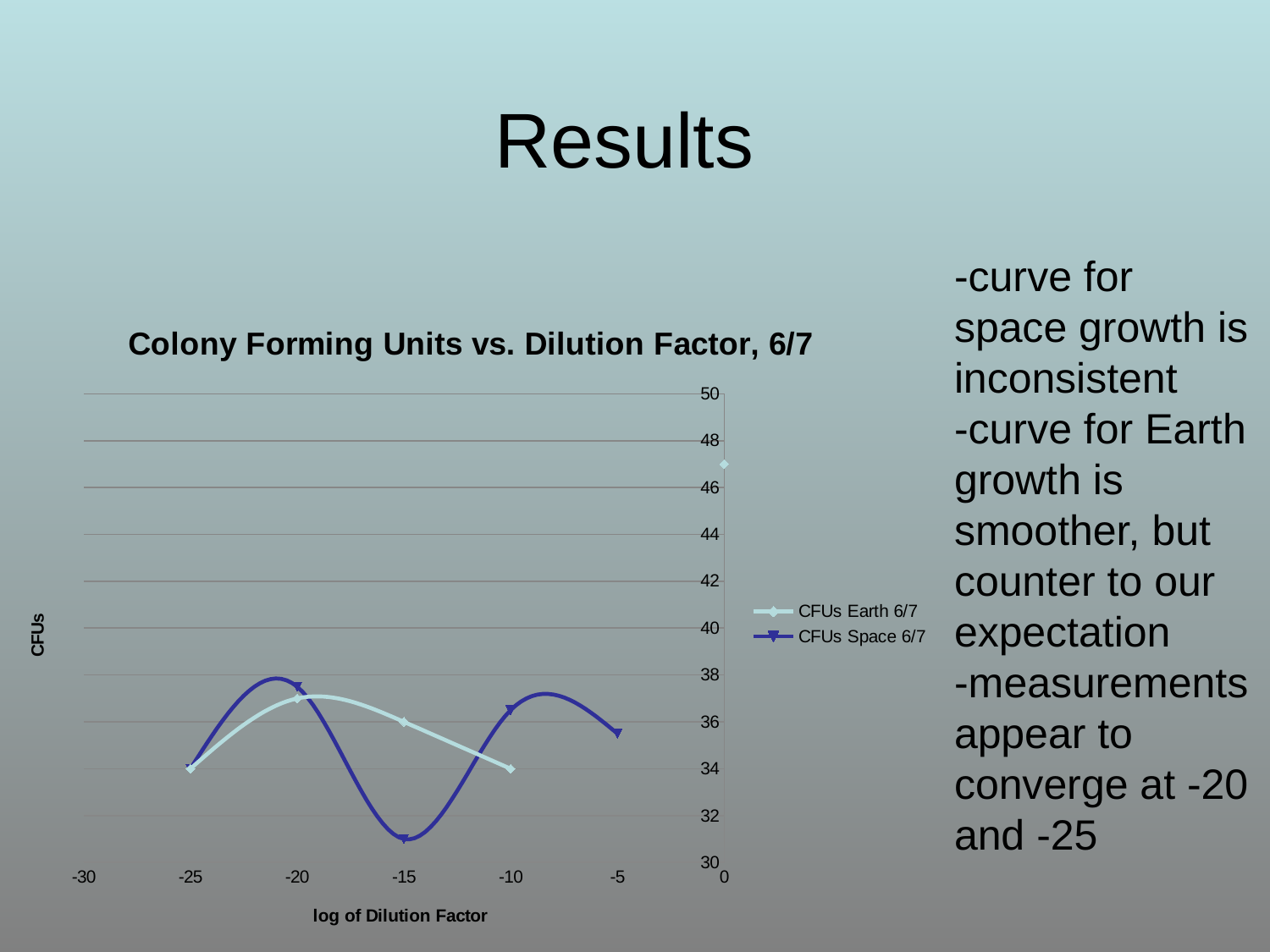
Is the value for CFUs Space 6/7 at a log of dilution factor of -15 greater or less than 32? less At a log of dilution factor of -10, which series has the higher value, CFUs Earth 6/7 or CFUs Space 6/7? CFUs Space 6/7 What are the two series named in the legend? CFUs Earth 6/7 and CFUs Space 6/7 At which log of dilution factor does the CFUs Space 6/7 series reach its highest value? -20 Is the value for CFUs Space 6/7 at a log of dilution factor of -20 greater or less than 36? greater Is the value for CFUs Earth 6/7 at a log of dilution factor of -20 greater or less than 36? greater What is the title of the chart? Colony Forming Units vs. Dilution Factor, 6/7 How many series does the legend list? 2 What kind of chart is shown on the slide? line chart Does the CFUs Earth 6/7 series rise or fall between a log of dilution factor of -20 and -10? fall At which log of dilution factor does the CFUs Space 6/7 series reach its lowest value? -15 At a log of dilution factor of -15, which series has the higher value, CFUs Earth 6/7 or CFUs Space 6/7? CFUs Earth 6/7